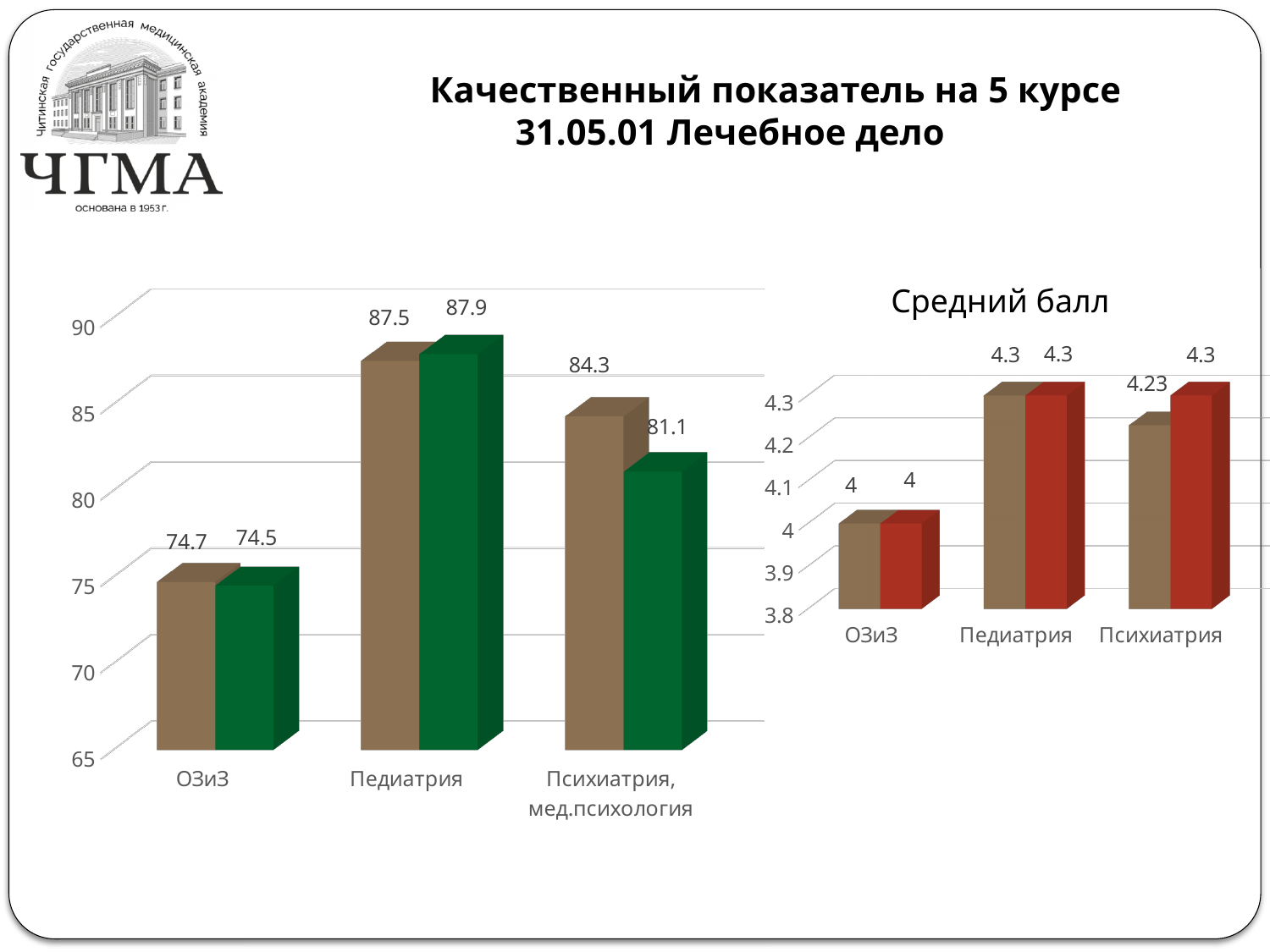
In the chart titled Средний балл, what is the value of the brown bar for Психиатрия? 4.23 In the left chart, what is the difference between the brown and green bars for Психиатрия, мед.психология? 3.2 In the left chart, what is the value of the green bar for ОЗиЗ? 74.5 In the chart titled Средний балл, what is the value of the red bar for ОЗиЗ? 4 In the left chart, which category has the lowest brown bar? ОЗиЗ In the chart titled Средний балл, which is larger for Психиатрия: the brown bar or the red bar? the red bar In the left chart, what is the value of the brown bar for Педиатрия? 87.5 How many categories are shown on the x axis of the left chart? 3 In the left chart, is the brown bar for Психиатрия, мед.психология greater or less than 80? greater In the left chart, what is the value of the green bar for Психиатрия, мед.психология? 81.1 What type of chart is the chart titled Средний балл? bar chart In the left chart, which category has the highest green bar? Педиатрия